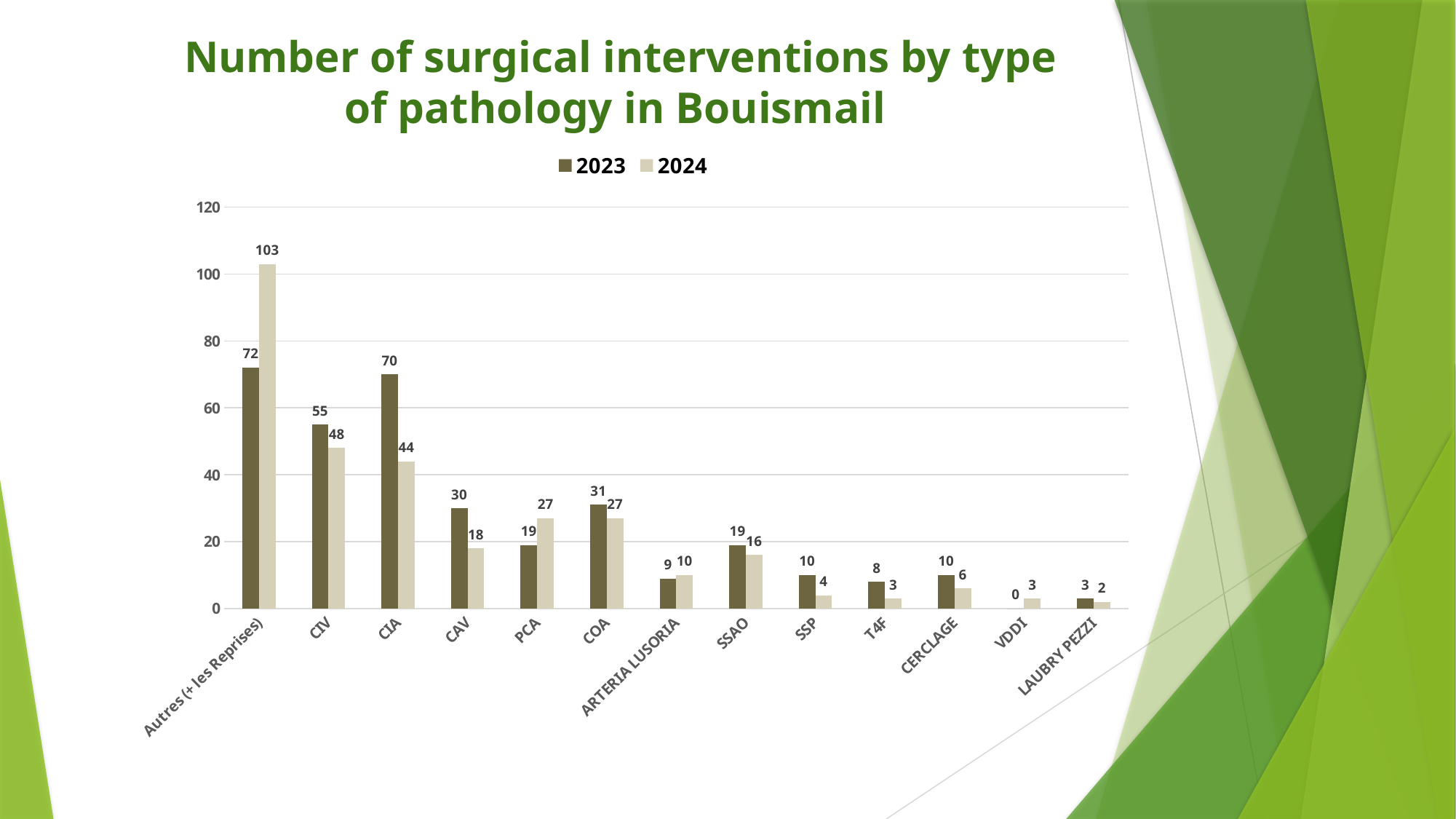
What is the value for VDDI in 2023? 0 What is the total of the 2023 and 2024 values for COA? 58 What is the value for CIV in 2023? 55 Which category has the lowest value in 2023? VDDI How many categories are shown on the x axis? 13 How many series does the legend list? 2 Which category has the highest value in 2024? Autres (+ les Reprises) Which is larger for PCA, the 2023 value or the 2024 value? 2024 What is the difference between the 2024 and 2023 values for Autres (+ les Reprises)? 31 What is the title of the chart? Number of surgical interventions by type of pathology in Bouismail What is the value for CAV in 2024? 18 What kind of chart is shown on the slide? Bar chart